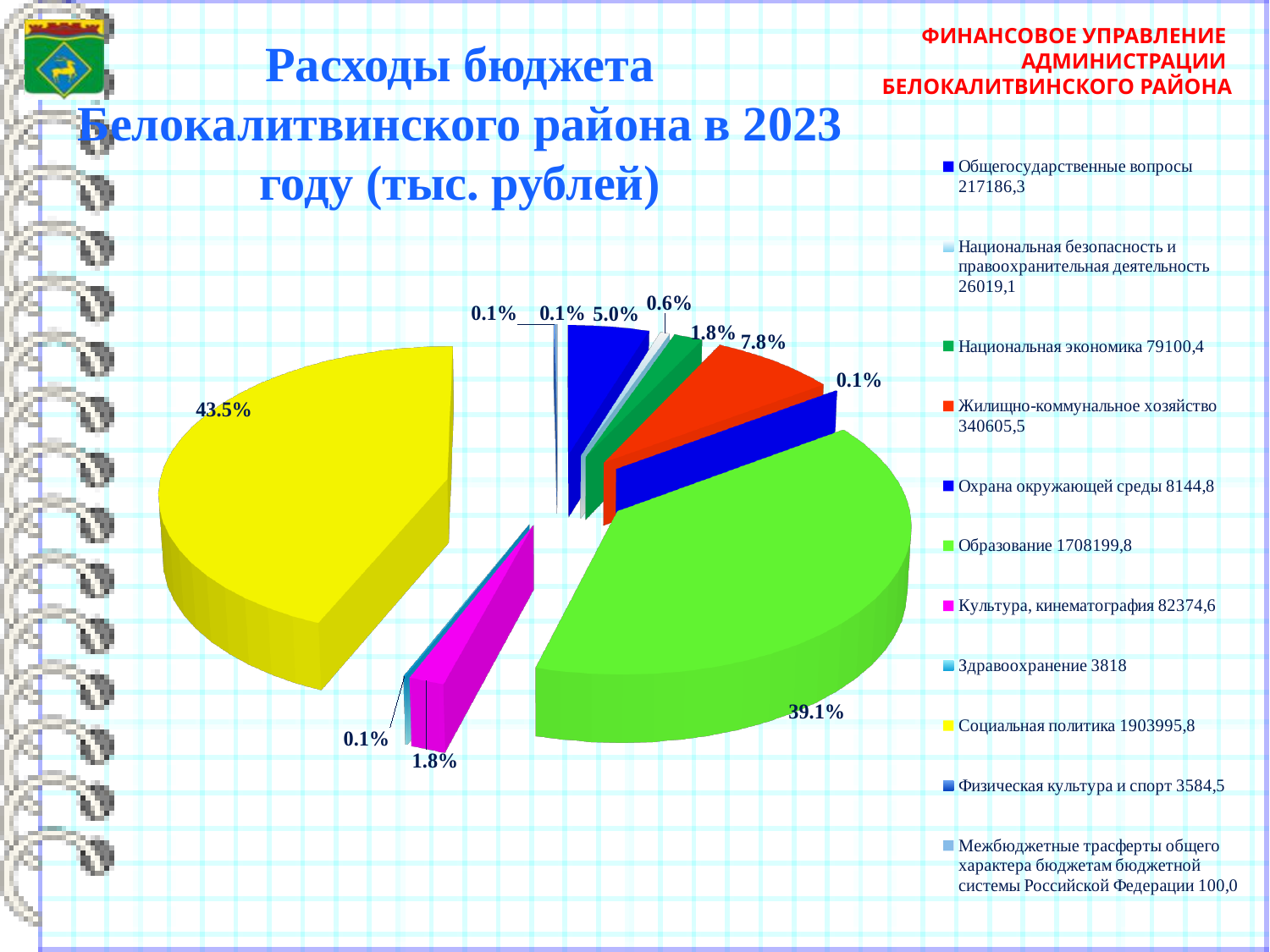
What is the value for Жилищно-коммунальное хозяйство in the legend? 340605,5 What is the value for Образование in the legend? 1708199,8 What is the difference between the values for Культура, кинематография and Национальная экономика? 3274,2 What is the value for Охрана окружающей среды in the legend? 8144,8 What kind of chart is shown on the slide? pie chart Which category has the smallest value in the legend? Межбюджетные трасферты общего характера бюджетам бюджетной системы Российской Федерации What share of the pie does Образование (the light green slice) take? 39.1% Which category has the largest share of the pie? Социальная политика What is the value for Здравоохранение in the legend? 3818 How many categories does the legend list? 11 Which is larger, the value for Культура, кинематография or the value for Национальная экономика? Культура, кинематография What share of the pie does Социальная политика (the yellow slice) take? 43.5%